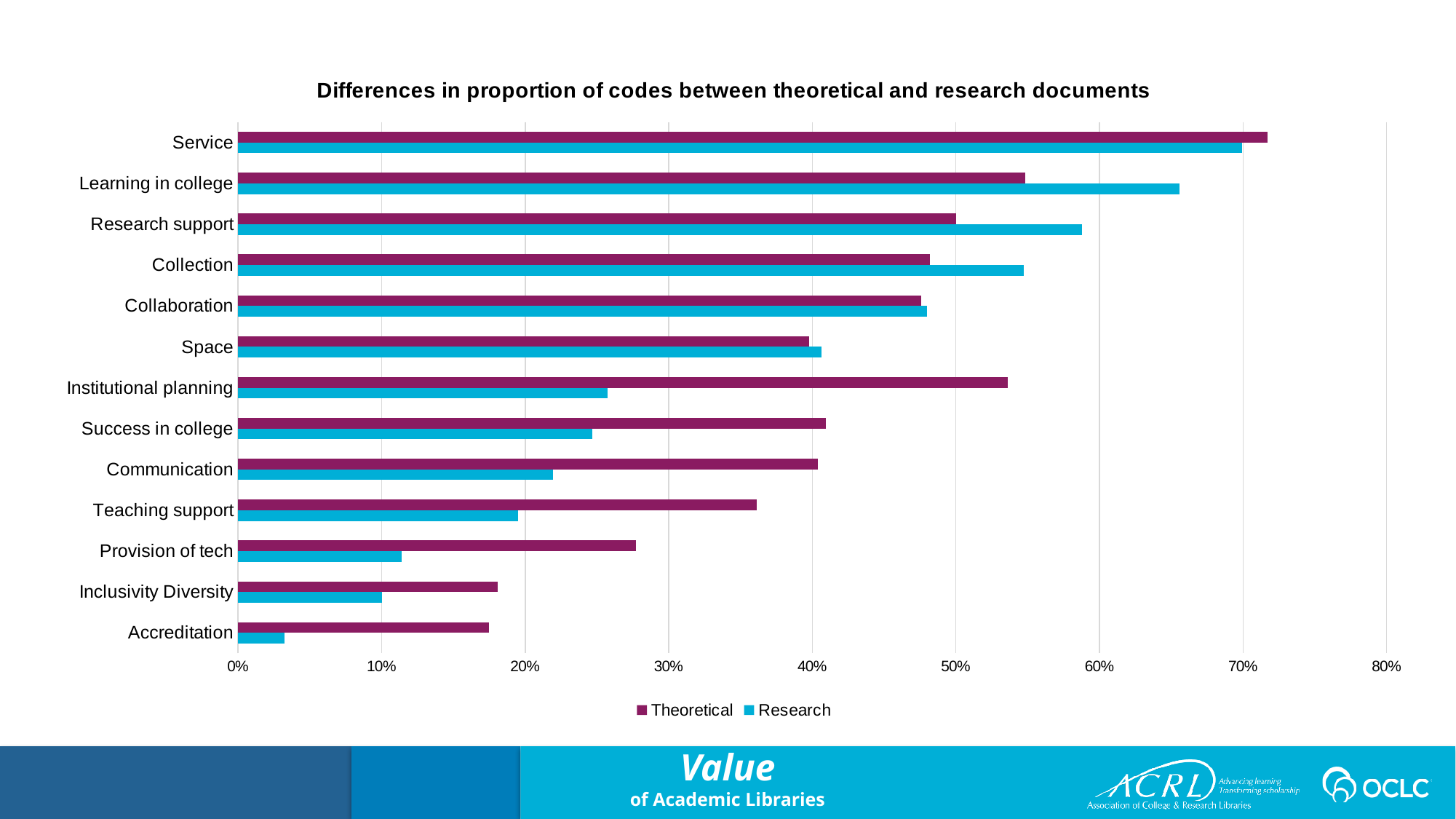
Which category has the lowest Research value? Accreditation How many series does the legend list? 2 What is the title of the chart? Differences in proportion of codes between theoretical and research documents Which category has the highest Theoretical value? Service Is the Research value for Accreditation greater or less than 10%? less Is the Research value for Institutional planning greater or less than 30%? less What kind of chart is shown on the slide? bar chart How many categories are plotted on the chart? 13 For Institutional planning, which series has the larger value, Theoretical or Research? Theoretical Which category has the highest Research value? Service Is the Research value for Learning in college greater or less than 60%? greater